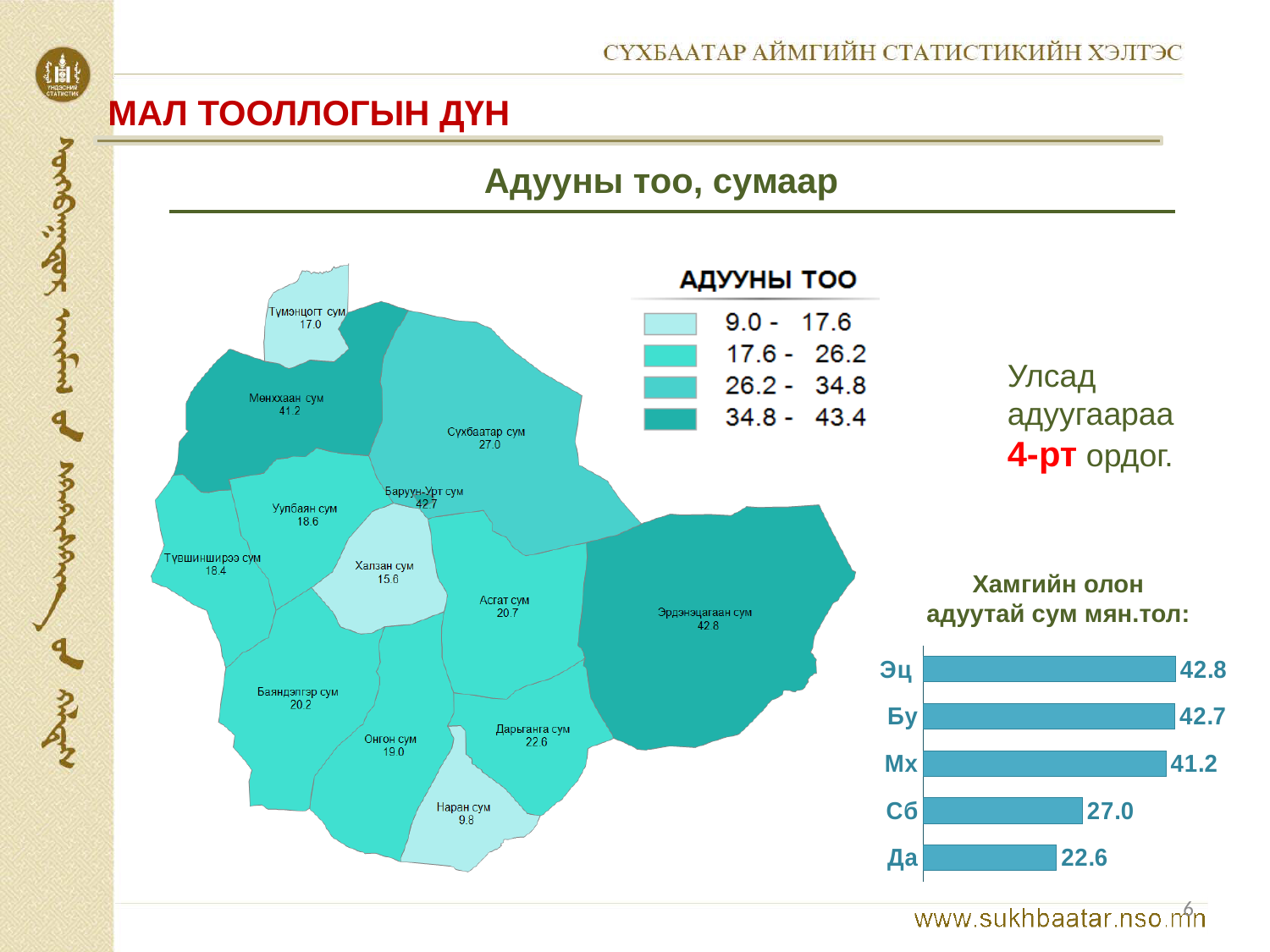
In the bar chart titled 'Хамгийн олон адуутай сум мян.тол:', which category has the highest value? Эц How many categories are shown in the bar chart titled 'Хамгийн олон адуутай сум мян.тол:'? 5 In the bar chart titled 'Хамгийн олон адуутай сум мян.тол:', which category has the lowest value? Да In the bar chart titled 'Хамгийн олон адуутай сум мян.тол:', do the values rise or fall going from the top bar to the bottom bar? Fall In the bar chart titled 'Хамгийн олон адуутай сум мян.тол:', what is the value for Сб? 27.0 In the bar chart titled 'Хамгийн олон адуутай сум мян.тол:', what is the value for Эц? 42.8 In the bar chart titled 'Хамгийн олон адуутай сум мян.тол:', what is the value for Да? 22.6 What kind of chart is the one titled 'Хамгийн олон адуутай сум мян.тол:'? Bar chart On the map, what is the value shown for Наран сум? 9.8 On the map legend 'АДУУНЫ ТОО', what is the range of the darkest colour class? 34.8 - 43.4 In the bar chart titled 'Хамгийн олон адуутай сум мян.тол:', what is the difference between the values for Мх and Сб? 14.2 In the bar chart titled 'Хамгийн олон адуутай сум мян.тол:', which is larger, the value for Сб or the value for Да? Сб